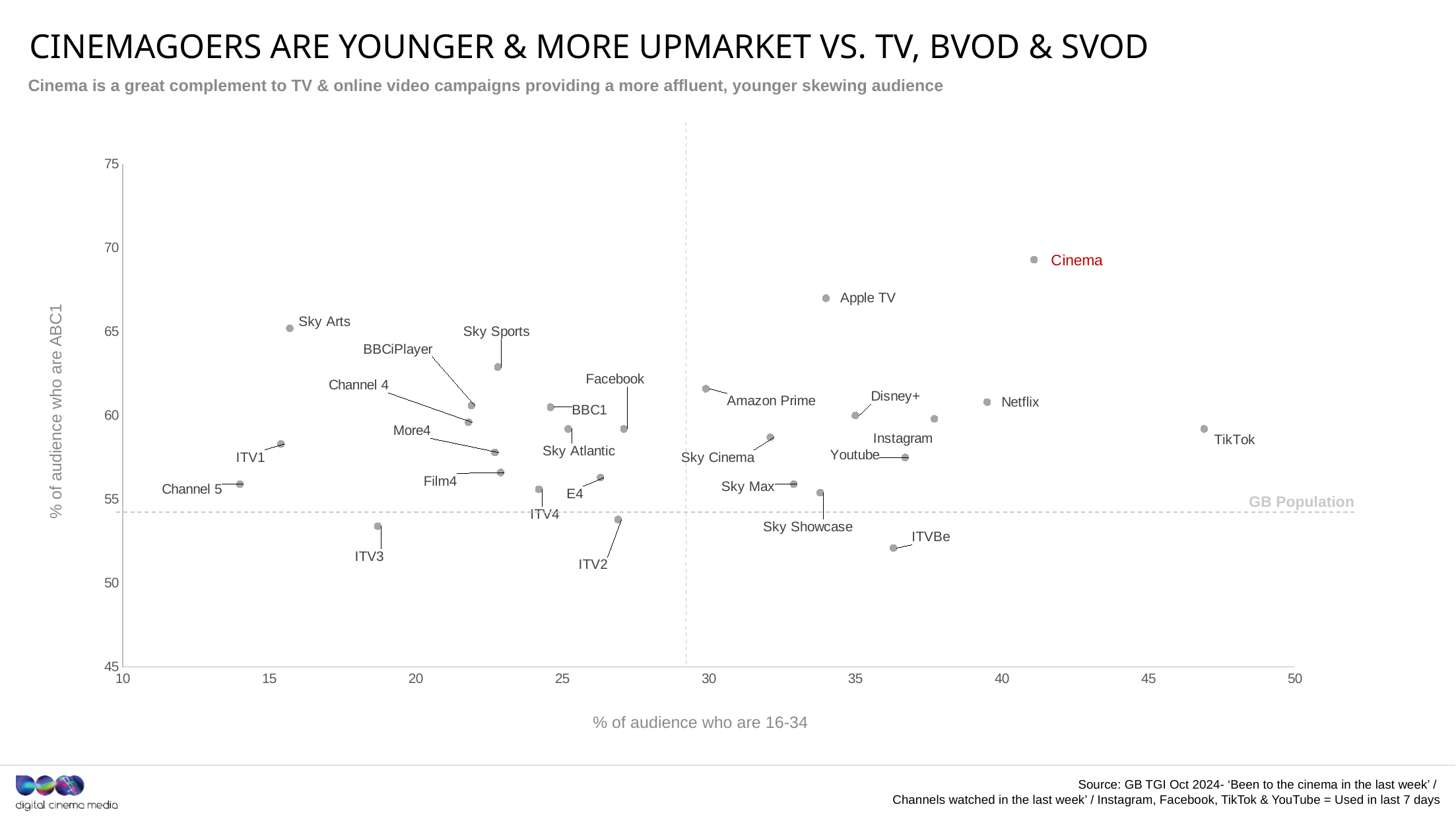
Which point has the highest % of audience who are 16-34? TikTok Which point has the lowest % of audience who are ABC1? ITVBe Which point has the lowest % of audience who are 16-34? Channel 5 Which has a higher % of audience who are 16-34, TikTok or Netflix? TikTok What kind of chart is shown on the slide? Scatter chart Which point has the highest % of audience who are ABC1? Cinema Is the % of audience who are 16-34 for TikTok greater or less than 45? greater Which has a higher % of audience who are ABC1, Cinema or Apple TV? Cinema Is the % of audience who are ABC1 for Cinema greater or less than 65? greater What is the label on the horizontal dashed reference line? GB Population Is the % of audience who are ABC1 for ITVBe greater or less than 55? less